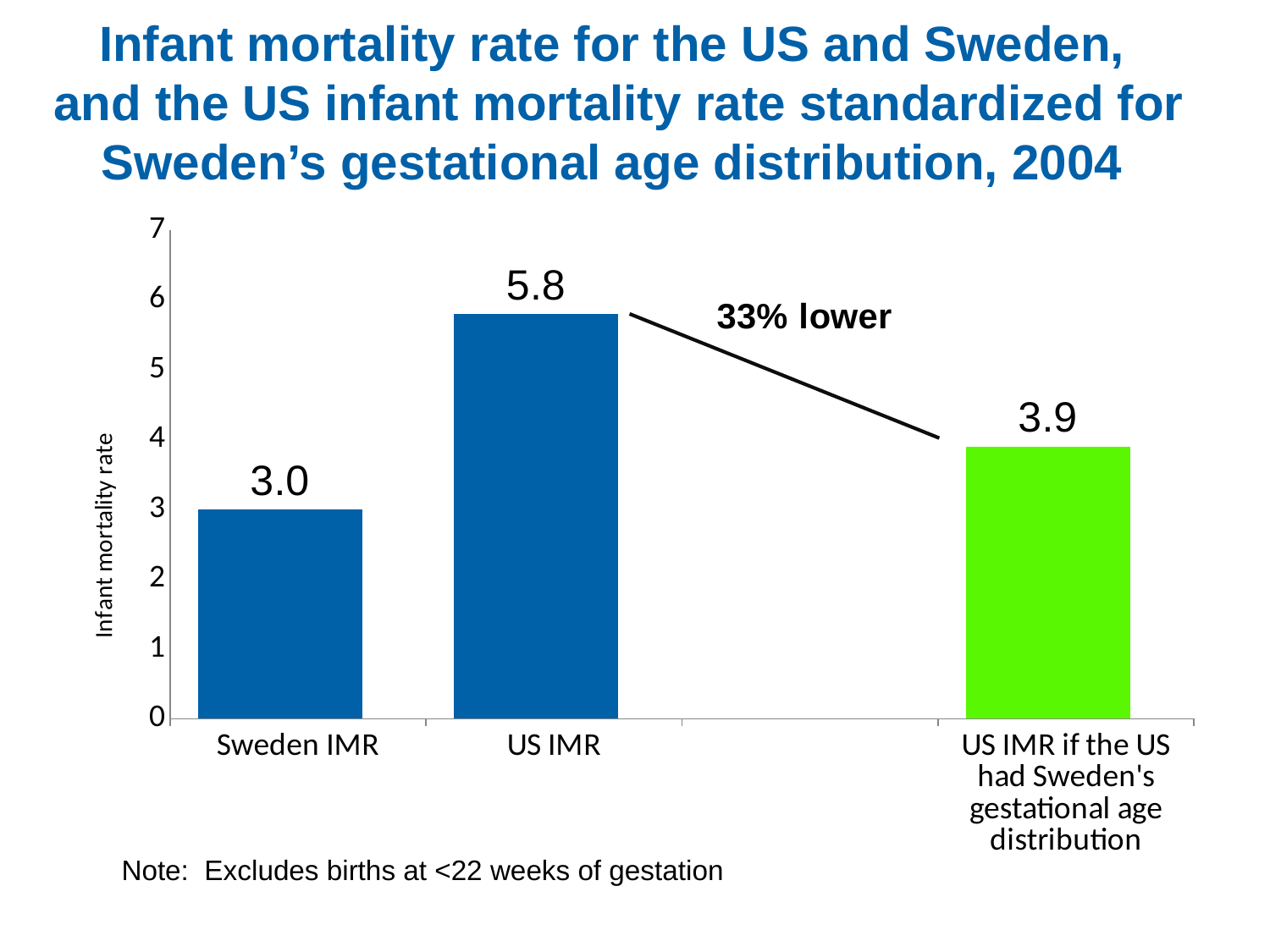
How many bars are plotted in the chart? 3 What is the difference between the US IMR and the Sweden IMR? 2.8 Which category has the highest infant mortality rate? US IMR According to the annotation on the chart, by what percentage is the standardized US IMR lower than the actual US IMR? 33% lower What is the difference between the US IMR and the US IMR standardized for Sweden's gestational age distribution? 1.9 What is the value shown for the US IMR if the US had Sweden's gestational age distribution? 3.9 Which is larger, the Sweden IMR or the US IMR if the US had Sweden's gestational age distribution? US IMR if the US had Sweden's gestational age distribution Which category has the lowest infant mortality rate? Sweden IMR What kind of chart is shown on the slide? Bar chart What is the infant mortality rate shown for US IMR? 5.8 What is the infant mortality rate shown for Sweden IMR? 3.0 Is the value for US IMR greater or less than 5? greater